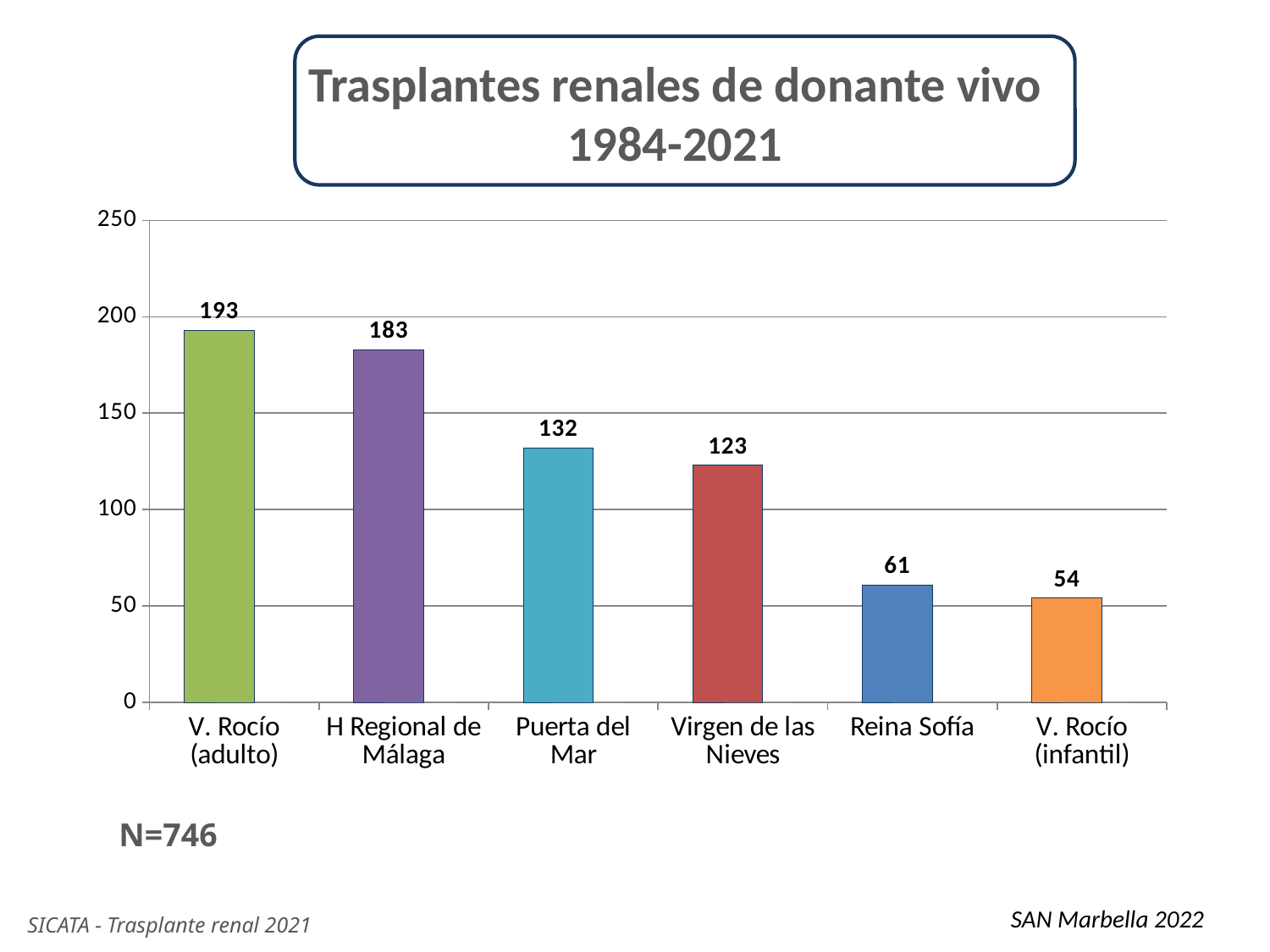
What is the value for Reina Sofía? 61 What is the difference between the values for Puerta del Mar and Virgen de las Nieves? 9 What is the title of the chart? Trasplantes renales de donante vivo 1984-2021 What is the value for Puerta del Mar? 132 Which is larger, the value for Virgen de las Nieves or the value for Reina Sofía? Virgen de las Nieves How many categories are shown on the x axis? 6 What kind of chart is shown on the slide? bar chart Is the value for H Regional de Málaga greater or less than 150? greater Which category has the highest value? V. Rocío (adulto) What is the difference between the values for V. Rocío (adulto) and H Regional de Málaga? 10 Which category has the lowest value? V. Rocío (infantil) What is the value for V. Rocío (adulto)? 193